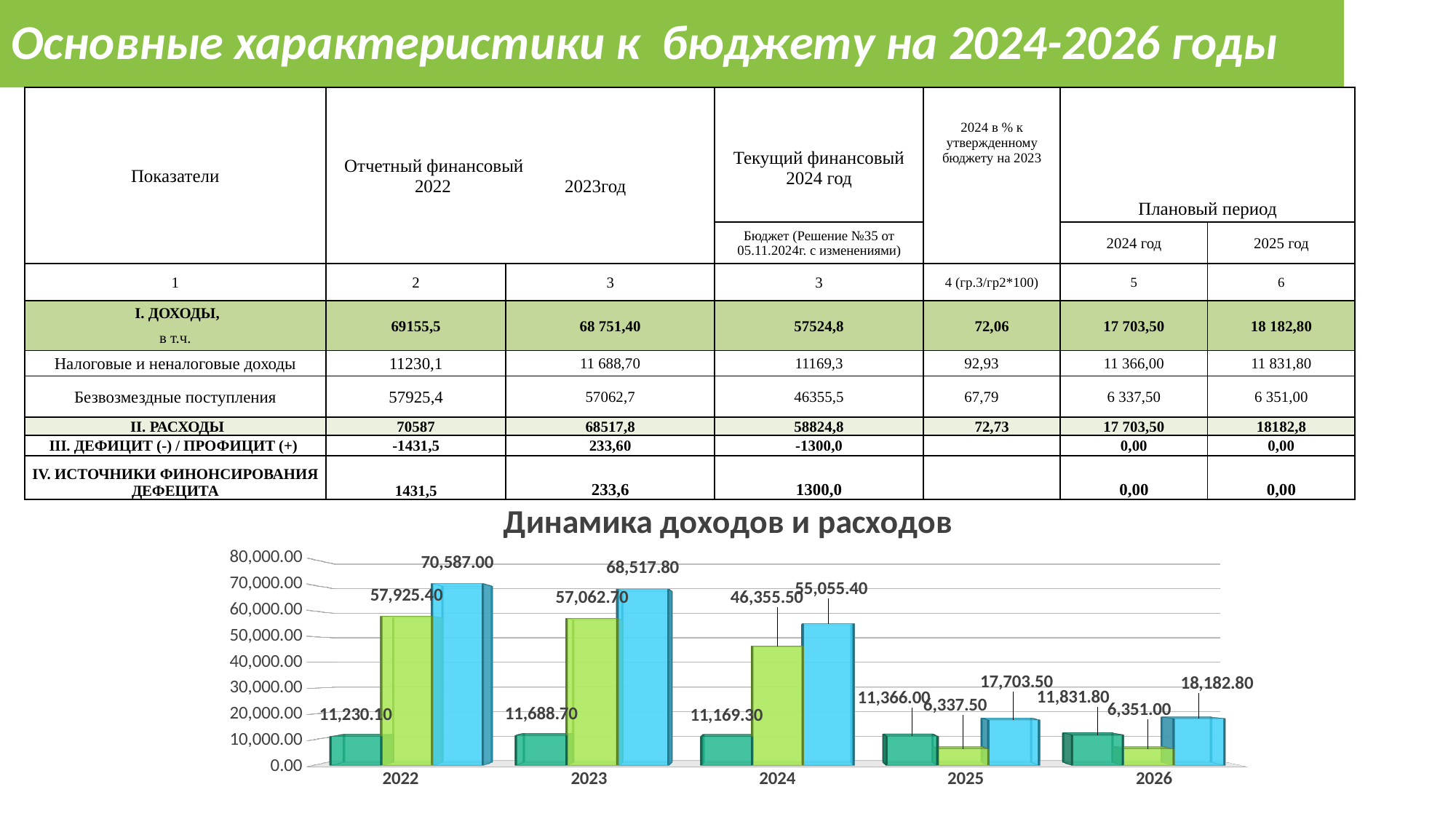
In the chart 'Динамика доходов и расходов', what is the value of the dark green bar for 2026? 11,831.80 In the chart 'Динамика доходов и расходов', what is the value of the light green bar for 2024? 46,355.50 In the chart 'Динамика доходов и расходов', what is the value of the blue bar for 2025? 17,703.50 What type of chart is 'Динамика доходов и расходов'? bar chart What is the title of the chart on the slide? Динамика доходов и расходов In the chart 'Динамика доходов и расходов', which year has the lowest light green bar? 2025 In the chart 'Динамика доходов и расходов', what is the value of the blue bar for 2022? 70,587.00 How many year categories are shown on the x axis of the chart 'Динамика доходов и расходов'? 5 In the chart 'Динамика доходов и расходов', do the blue bar values rise or fall from 2022 to 2025? fall In the chart 'Динамика доходов и расходов', which year has the highest blue bar? 2022 In the chart 'Динамика доходов и расходов', which is larger for 2025: the dark green bar or the light green bar? the dark green bar In the chart 'Динамика доходов и расходов', what is the difference between the blue bar and the light green bar for 2023? 11,455.10